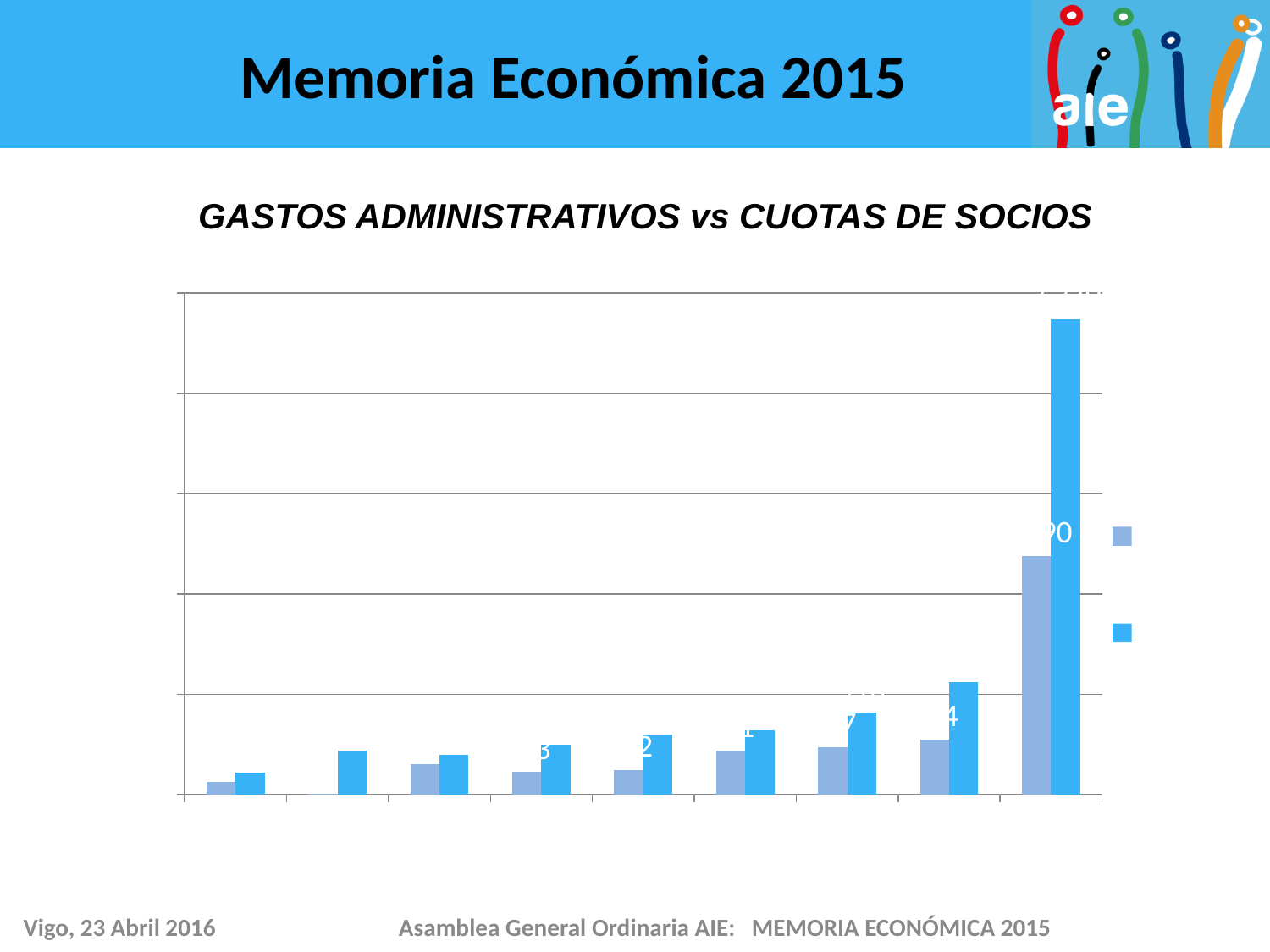
In the rightmost group of bars, which bar is taller, the light blue one or the dark blue one? the dark blue one What is the title shown above the chart? GASTOS ADMINISTRATIVOS vs CUOTAS DE SOCIOS Do the bar values generally rise or fall from left to right along the x axis? rise How many groups of bars are plotted along the x axis? 9 Which group of bars is the tallest in the chart? the rightmost group Which group of bars is the shortest in the chart? the leftmost group How many series does the legend list? 2 What kind of chart is shown on the slide? bar chart